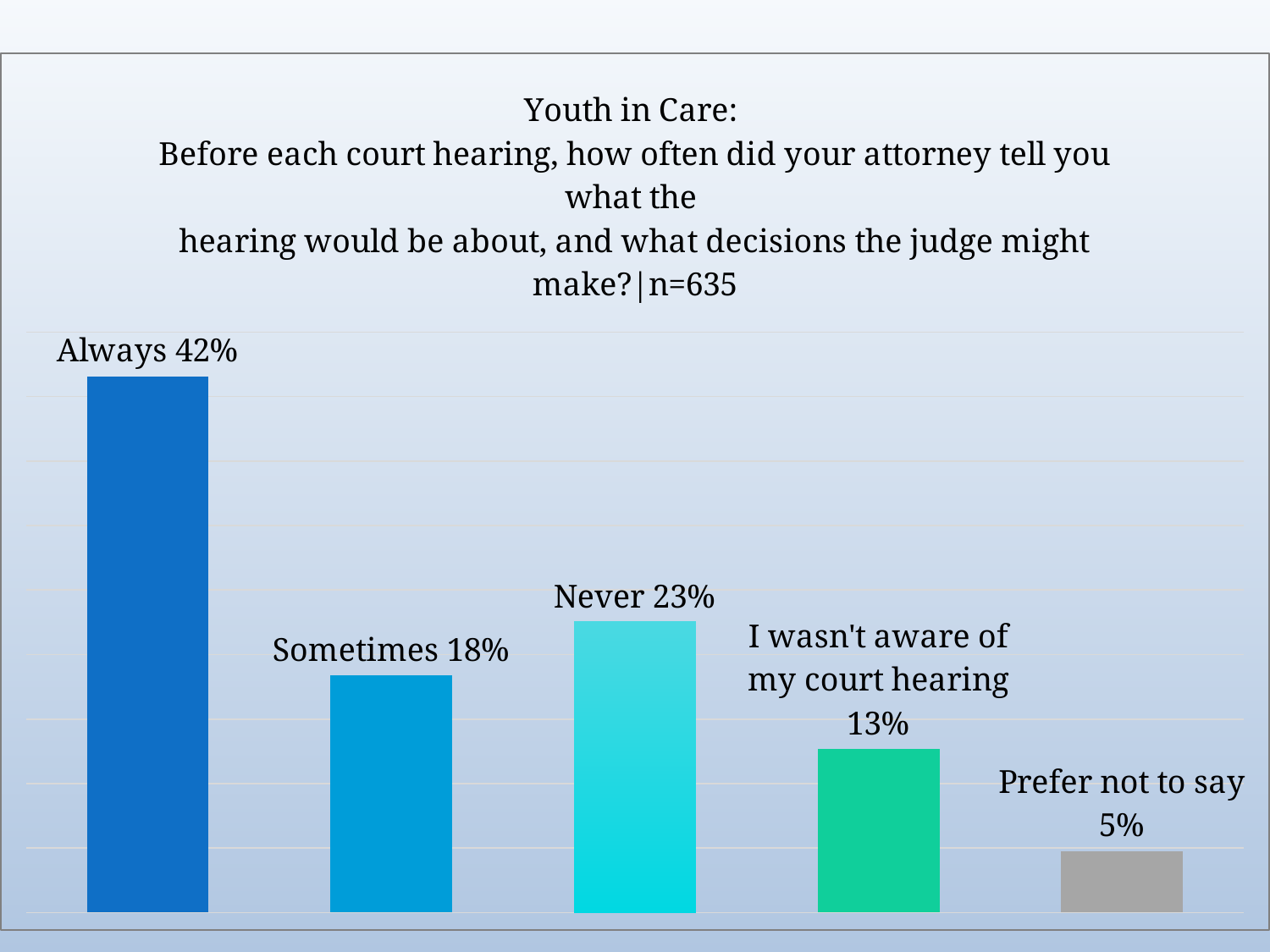
How many response categories are shown in the chart? 5 Which is larger, the percentage for "Sometimes" or the percentage for "Never"? Never What percentage of youth in care answered "Prefer not to say"? 5% Which response category has the highest percentage? Always What percentage of youth in care answered "Sometimes"? 18% What kind of chart is shown on the slide? Bar chart Which response category has the lowest percentage? Prefer not to say What percentage of youth in care answered "Always"? 42% What is the difference in percentage points between "Always" and "Never"? 19 What is the sample size (n) stated in the chart title? 635 What percentage of youth in care answered "I wasn't aware of my court hearing"? 13% What percentage of youth in care answered "Never"? 23%